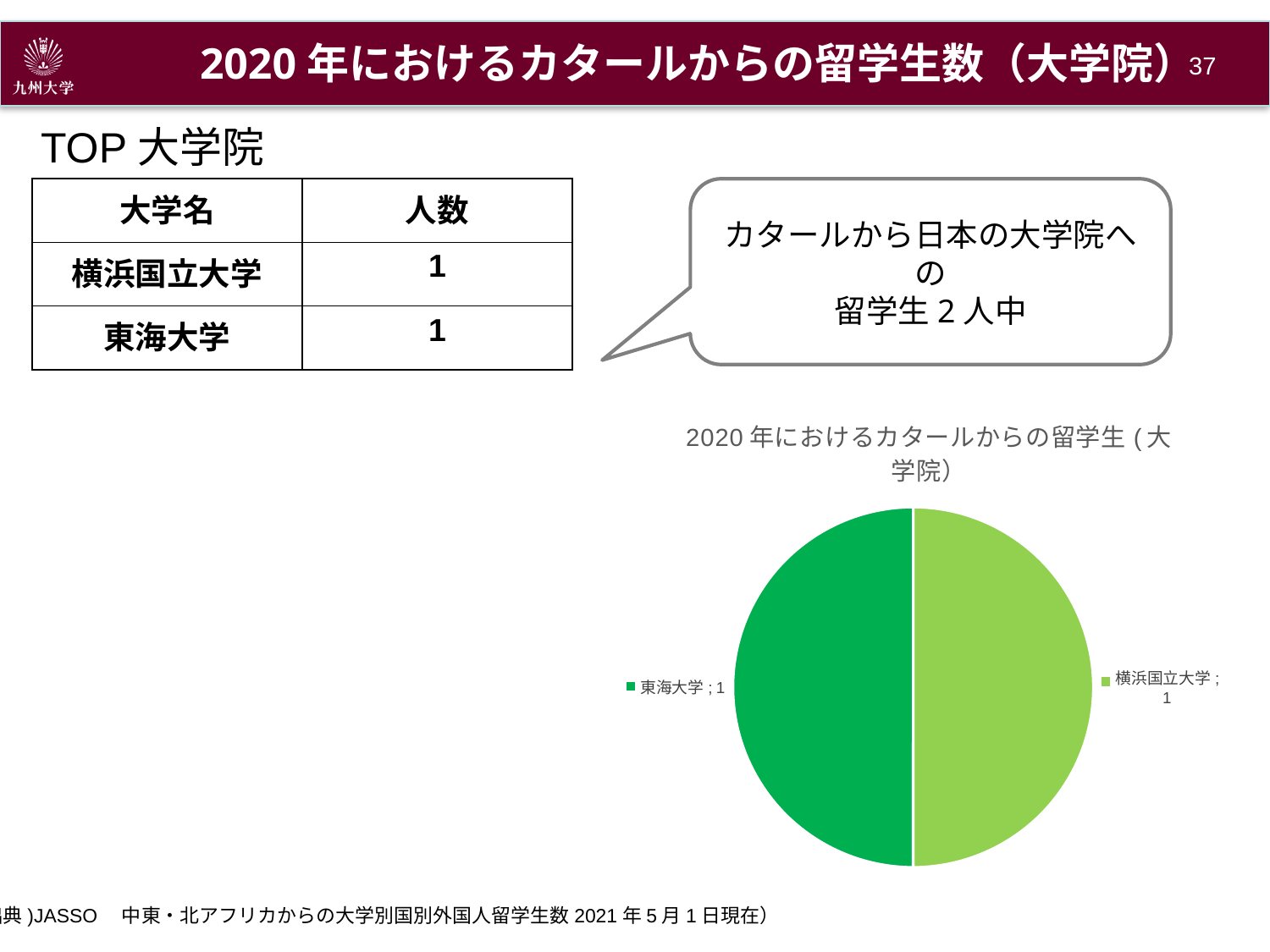
What is the value for 東海大学 in the pie chart? 1 How many slices does the pie chart have? 2 What is the total of all slices in the pie chart? 2 Which slice of the pie chart is shown in the lighter green colour? 横浜国立大学 What kind of chart is shown on the slide? pie chart What is the title of the pie chart? 2020年におけるカタールからの留学生(大学院) What share of the pie does 横浜国立大学 represent? 50% What share of the pie does 東海大学 represent? 50% What is the value for 横浜国立大学 in the pie chart? 1 What is the difference between the values for 東海大学 and 横浜国立大学 in the pie chart? 0